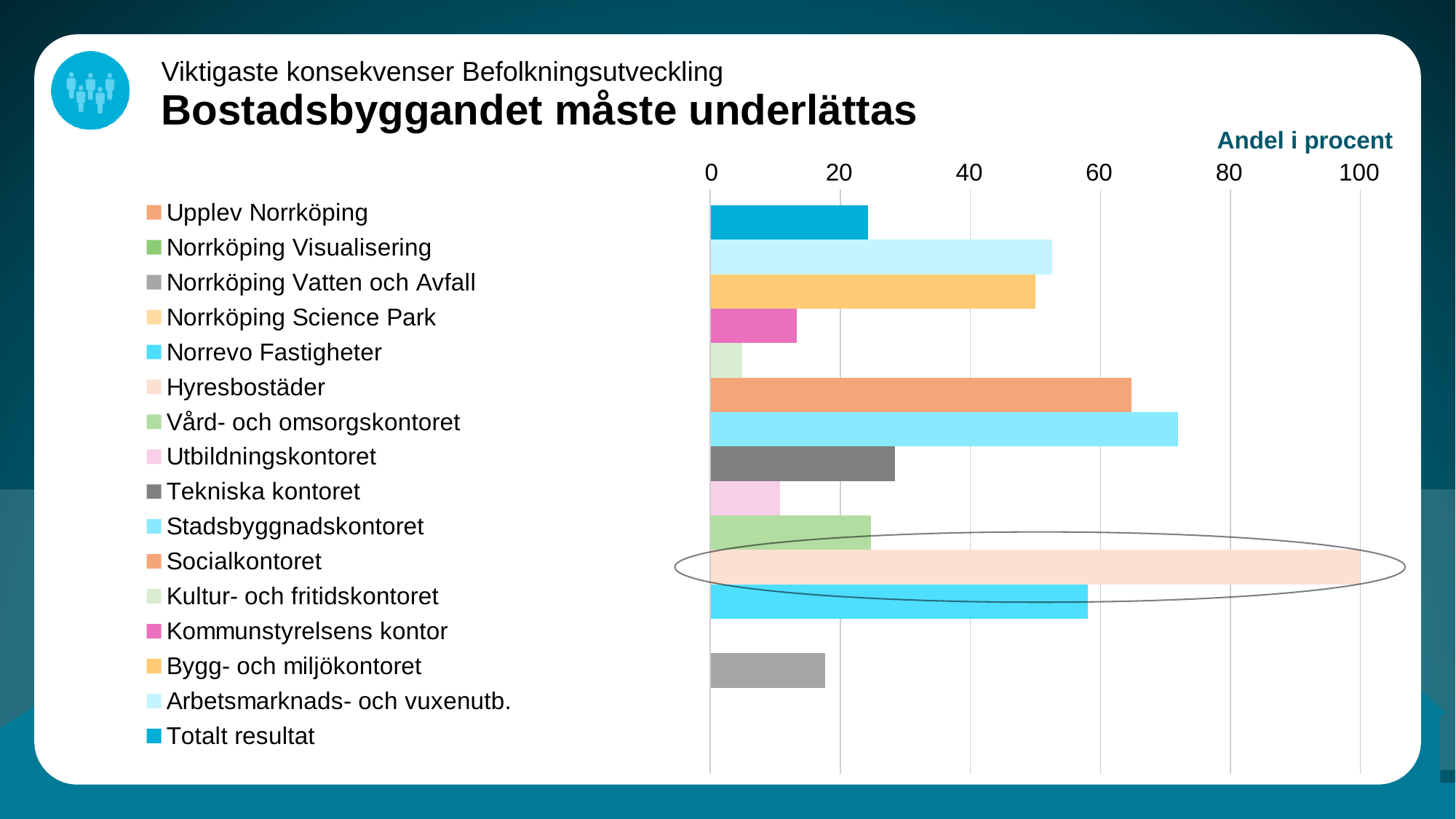
Is the value for Stadsbyggnadskontoret greater or less than 60? greater Is the value for Tekniska kontoret greater or less than 20? greater Which category has the highest value in the chart? Hyresbostäder Which is larger, the value for Tekniska kontoret or the value for Utbildningskontoret? Tekniska kontoret How many entries does the legend list? 16 Is the value for Kultur- och fritidskontoret greater or less than 20? less What is the value for Hyresbostäder? 100 What label is shown above the horizontal axis of the chart? Andel i procent What kind of chart is shown on the slide? bar chart Which is larger, the value for Stadsbyggnadskontoret or the value for Socialkontoret? Stadsbyggnadskontoret